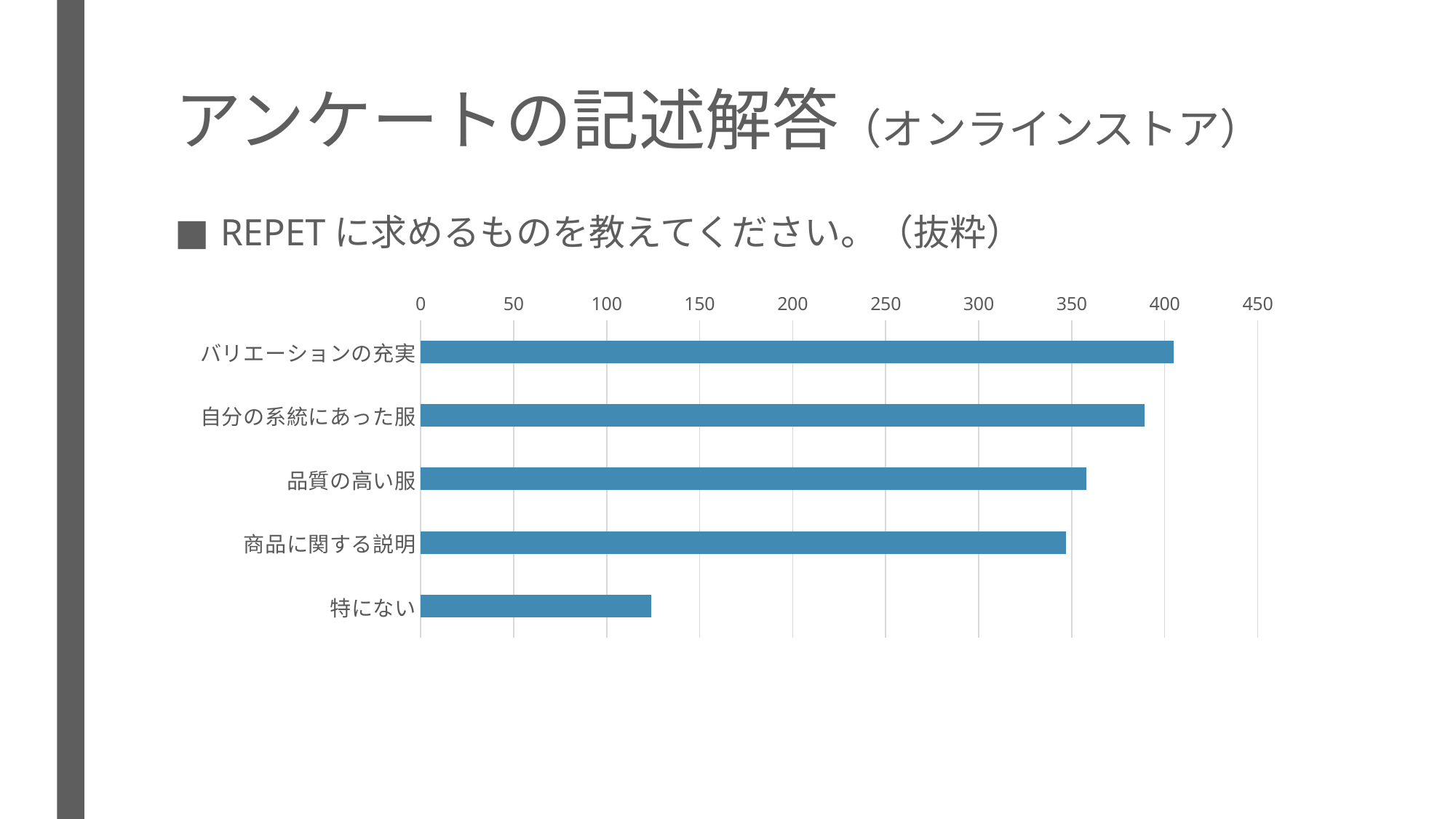
Which category has the lowest value? 特にない What kind of chart is shown on the slide? bar chart Is the value for 品質の高い服 greater or less than 300? greater Which category has the highest value? バリエーションの充実 How many categories are plotted in the chart? 5 What is the highest tick value shown on the value axis? 450 Is the value for 特にない greater or less than 150? less Is the value for バリエーションの充実 greater or less than 350? greater Which is larger, the value for 品質の高い服 or the value for 特にない? 品質の高い服 Which is larger, the value for バリエーションの充実 or the value for 商品に関する説明? バリエーションの充実